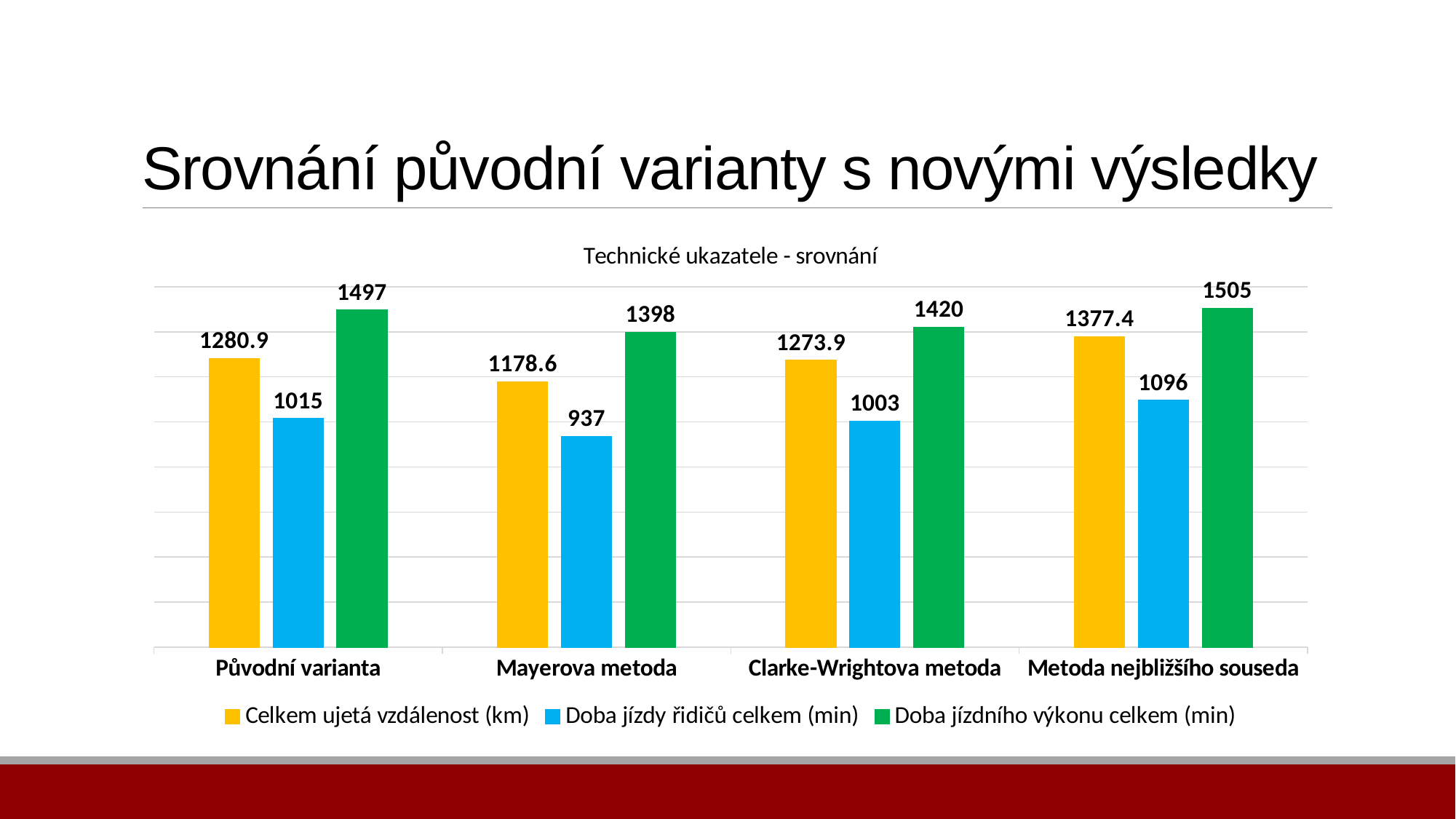
What is the value of Celkem ujetá vzdálenost (km) for Mayerova metoda? 1178.6 What is the difference between Celkem ujetá vzdálenost (km) for Metoda nejbližšího souseda and for Původní varianta? 96.5 Which category has the lowest value for Doba jízdy řidičů celkem (min)? Mayerova metoda What is the value of Doba jízdy řidičů celkem (min) for Clarke-Wrightova metoda? 1003 What type of chart is shown on the slide? bar chart Which category has the highest value for Doba jízdního výkonu celkem (min)? Metoda nejbližšího souseda Which series is shown in green? Doba jízdního výkonu celkem (min) What is the value of Doba jízdního výkonu celkem (min) for Původní varianta? 1497 How many categories are shown on the x axis? 4 Which is larger: Doba jízdy řidičů celkem (min) for Původní varianta or for Metoda nejbližšího souseda? Metoda nejbližšího souseda How many series does the legend list? 3 What is the title of the chart? Technické ukazatele - srovnání